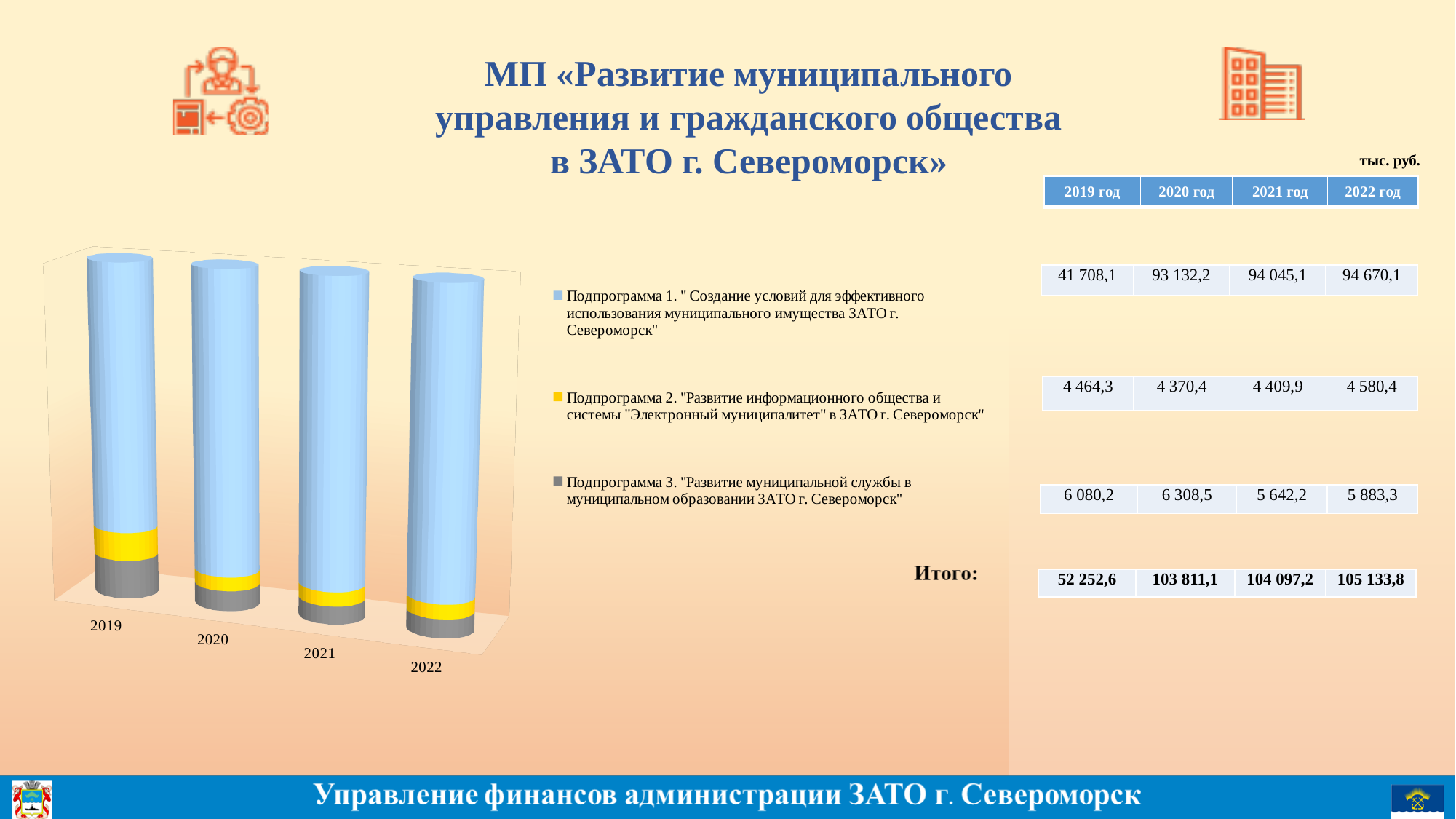
In which year is the value for Подпрограмма 3 the lowest? 2021 год Which colour represents Подпрограмма 2 in the chart? Yellow Which is larger: the Подпрограмма 2 value for 2019 год or for 2020 год? 2019 год How many series does the chart legend list? 3 Does the Итого (total) value rise or fall from 2019 to 2022? Rises What is the value for Подпрограмма 2 in 2022 год? 4 580,4 What is the Итого (total) value for 2022 год? 105 133,8 What kind of chart is shown on the slide? Stacked bar chart How many years (categories) are shown on the x axis of the chart? 4 What is the value for Подпрограмма 1 in 2019 год? 41 708,1 In which year is the value for Подпрограмма 1 the highest? 2022 год What is the difference between the Подпрограмма 3 values for 2020 год and 2019 год? 228,3